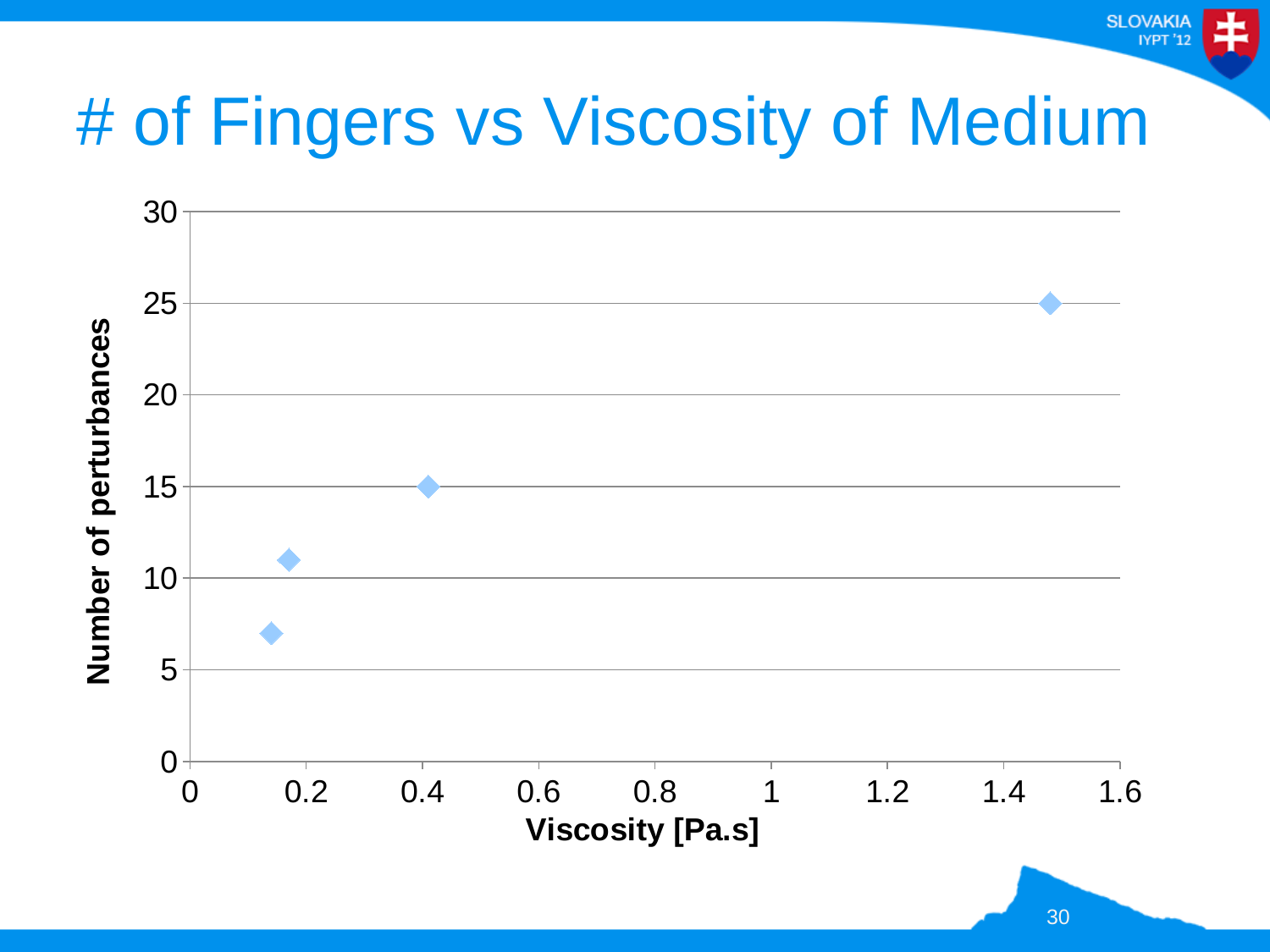
What is the Number of perturbances for the rightmost data point (at the highest viscosity)? 25 Is the Number of perturbances for the second data point from the left greater or less than 10? greater Is the Number of perturbances for the leftmost data point greater or less than 10? less Is the Number of perturbances for the rightmost data point greater or less than 20? greater What is the maximum value shown on the y axis? 30 What is the Number of perturbances for the data point at a viscosity of about 0.4 Pa.s? 15 Do the values of Number of perturbances rise or fall as viscosity increases along the x axis? rise What is the label of the x axis? Viscosity [Pa.s] How many data points are plotted on the chart? 4 What is the title of the chart on the slide? # of Fingers vs Viscosity of Medium What kind of chart is shown on the slide? scatter chart Which data point has the highest Number of perturbances: the one at the lowest viscosity or the one at the highest viscosity? the one at the highest viscosity